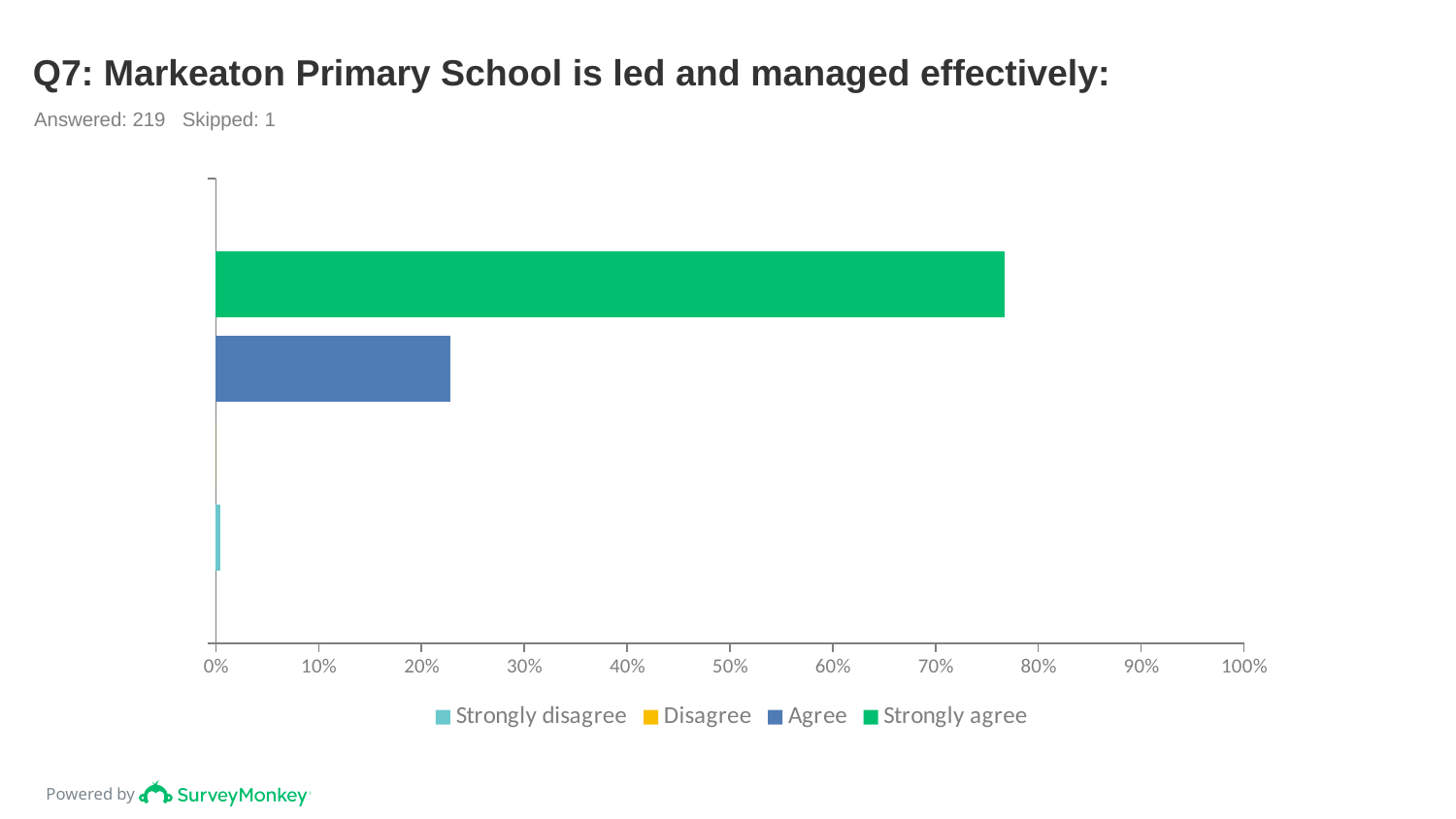
How many series does the legend list? 4 Is the value for Strongly agree greater or less than 80%? less Which is larger, the value for Strongly agree or the value for Agree? Strongly agree Is the value for Strongly disagree greater or less than 10%? less What kind of chart is shown on the slide? Bar chart Which response option has the highest value? Strongly agree What is the title of the chart? Q7: Markeaton Primary School is led and managed effectively: What is the highest value shown on the horizontal axis? 100% Is the value for Strongly agree greater or less than 70%? greater